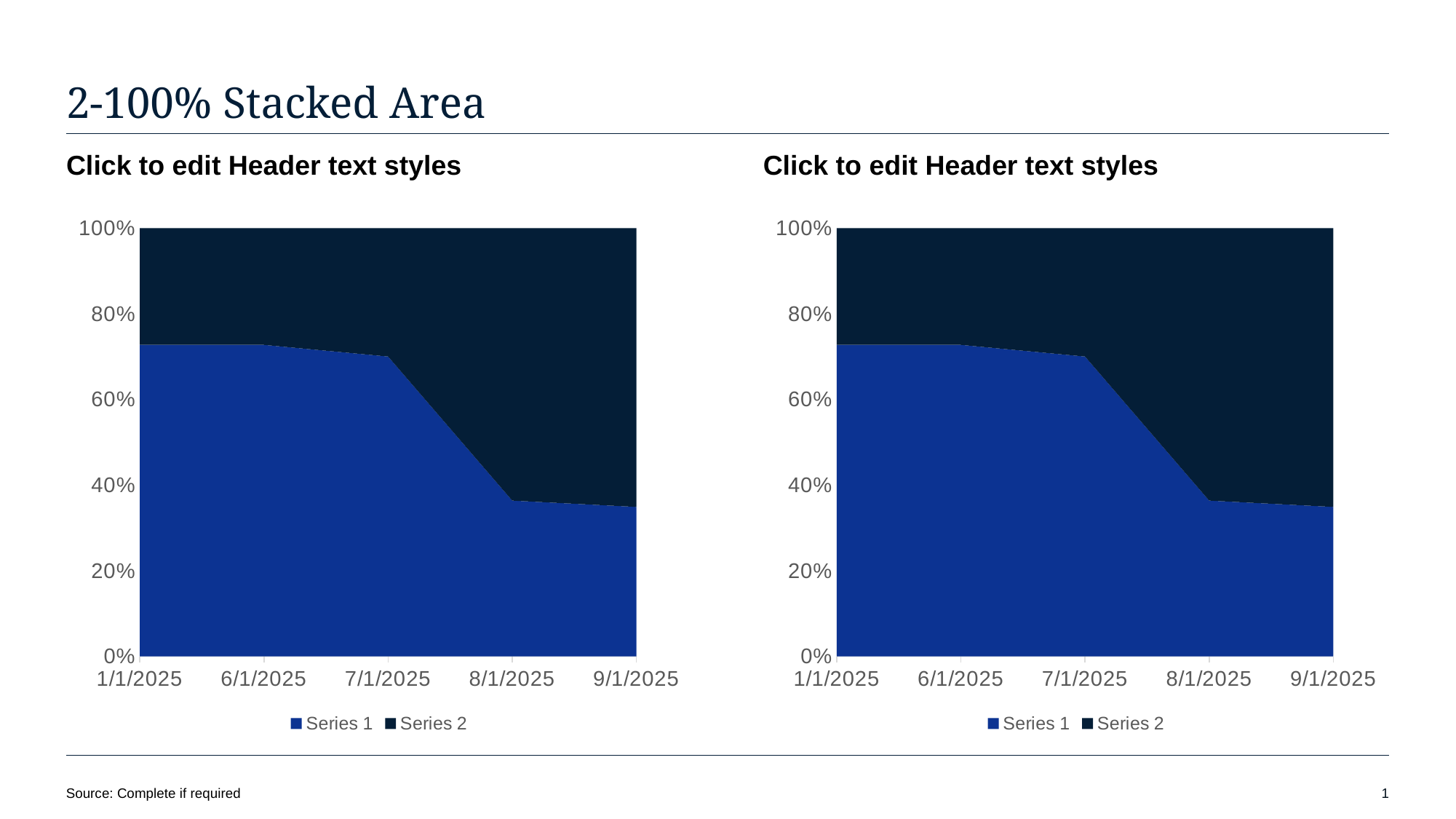
On the left chart, does the share of Series 1 rise or fall from 1/1/2025 to 9/1/2025? fall On the left chart, what are the names of the two series in the legend? Series 1 and Series 2 On the left chart, is the share of Series 1 at 1/1/2025 greater or less than 60%? greater On the right chart, is the share of Series 1 at 9/1/2025 greater or less than 40%? less On the left chart, how many series does the legend list? 2 On the right chart, does the share of Series 2 rise or fall from 1/1/2025 to 9/1/2025? rise On the right chart, is the share of Series 1 at 7/1/2025 greater or less than 80%? less On the right chart, which series is larger at 8/1/2025, Series 1 or Series 2? Series 2 What kind of chart is the left chart? 100% stacked area chart On the right chart, how many dates are shown on the x axis? 5 On the left chart, at which date is the share of Series 1 lowest? 9/1/2025